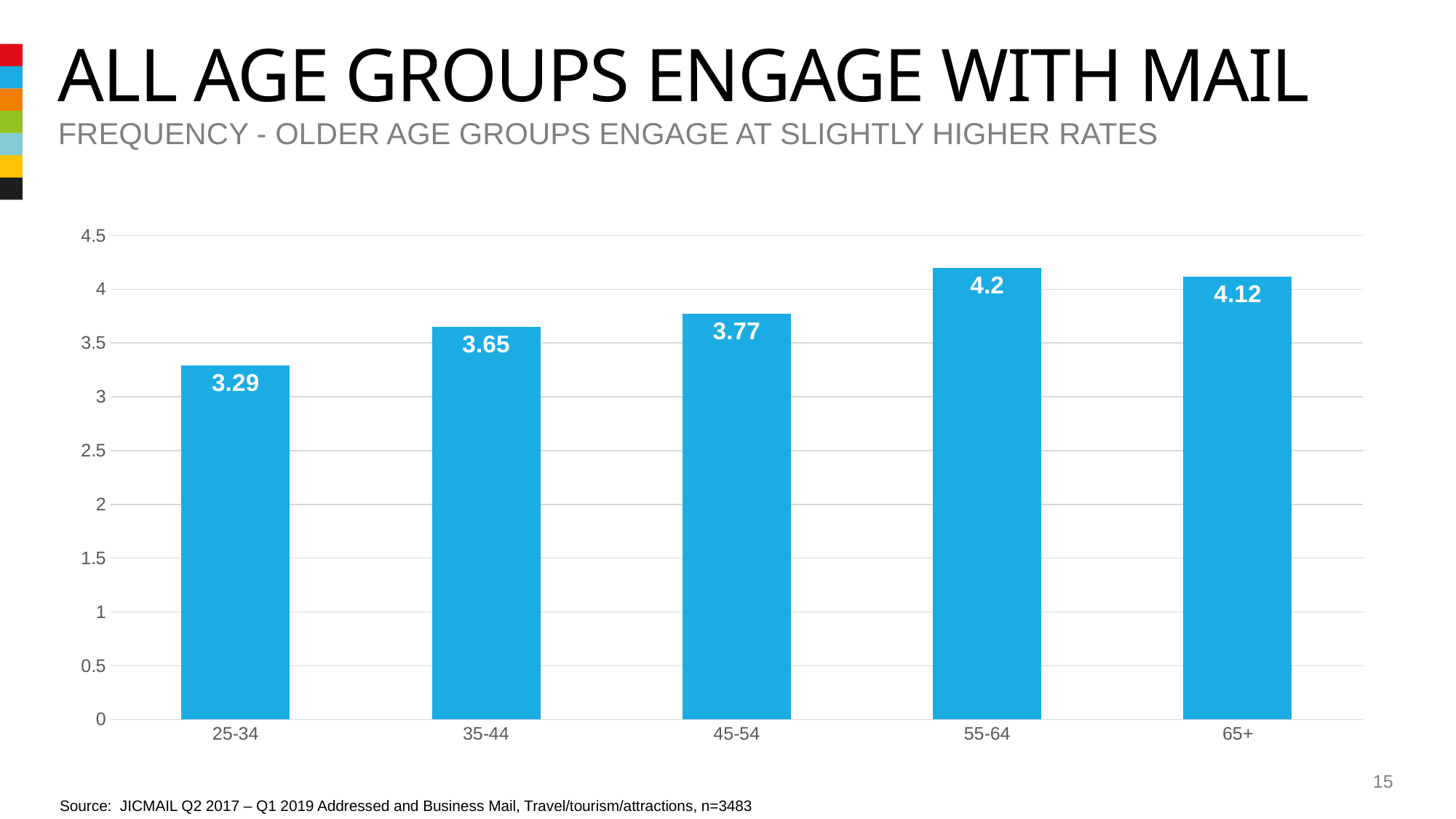
What kind of chart is shown on the slide? Bar chart What is the value for the 25-34 age group? 3.29 What is the value for the 45-54 age group? 3.77 How many age groups are shown on the chart? 5 What is the difference between the values for 45-54 and 35-44? 0.12 What is the value for the 65+ age group? 4.12 Is the value for 55-64 greater or less than 4? greater Which is larger, the value for 35-44 or the value for 65+? 65+ Which age group has the highest value? 55-64 Which age group has the lowest value? 25-34 Do the values generally rise or fall from the 25-34 group to the 55-64 group? Rise What is the difference between the values for 55-64 and 25-34? 0.91